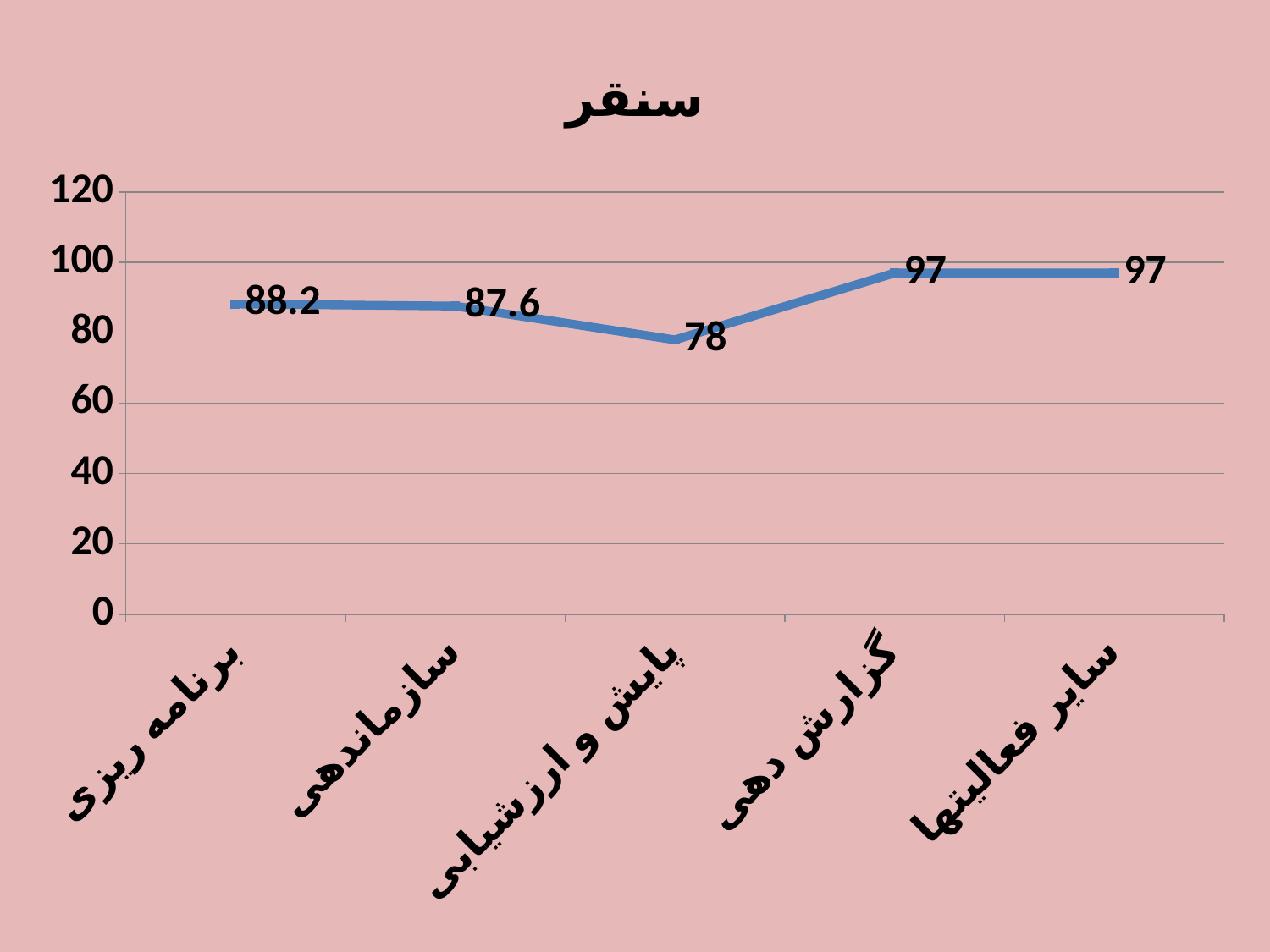
What kind of chart is this? line chart Which category has the lowest value? پایش و ارزشیابی What is the value for گزارش دهی? 97 What is the value for پایش و ارزشیابی? 78 How many categories are shown on the x axis? 5 What is the difference between the values for گزارش دهی and پایش و ارزشیابی? 19 What is the value for برنامه ریزی? 88.2 What is the value for سازماندهی? 87.6 What is the title of the chart? سنقر Is the value for پایش و ارزشیابی greater or less than 80? less Which is larger, the value for سایر فعالیتها or the value for برنامه ریزی? سایر فعالیتها What is the difference between the values for برنامه ریزی and سازماندهی? 0.6